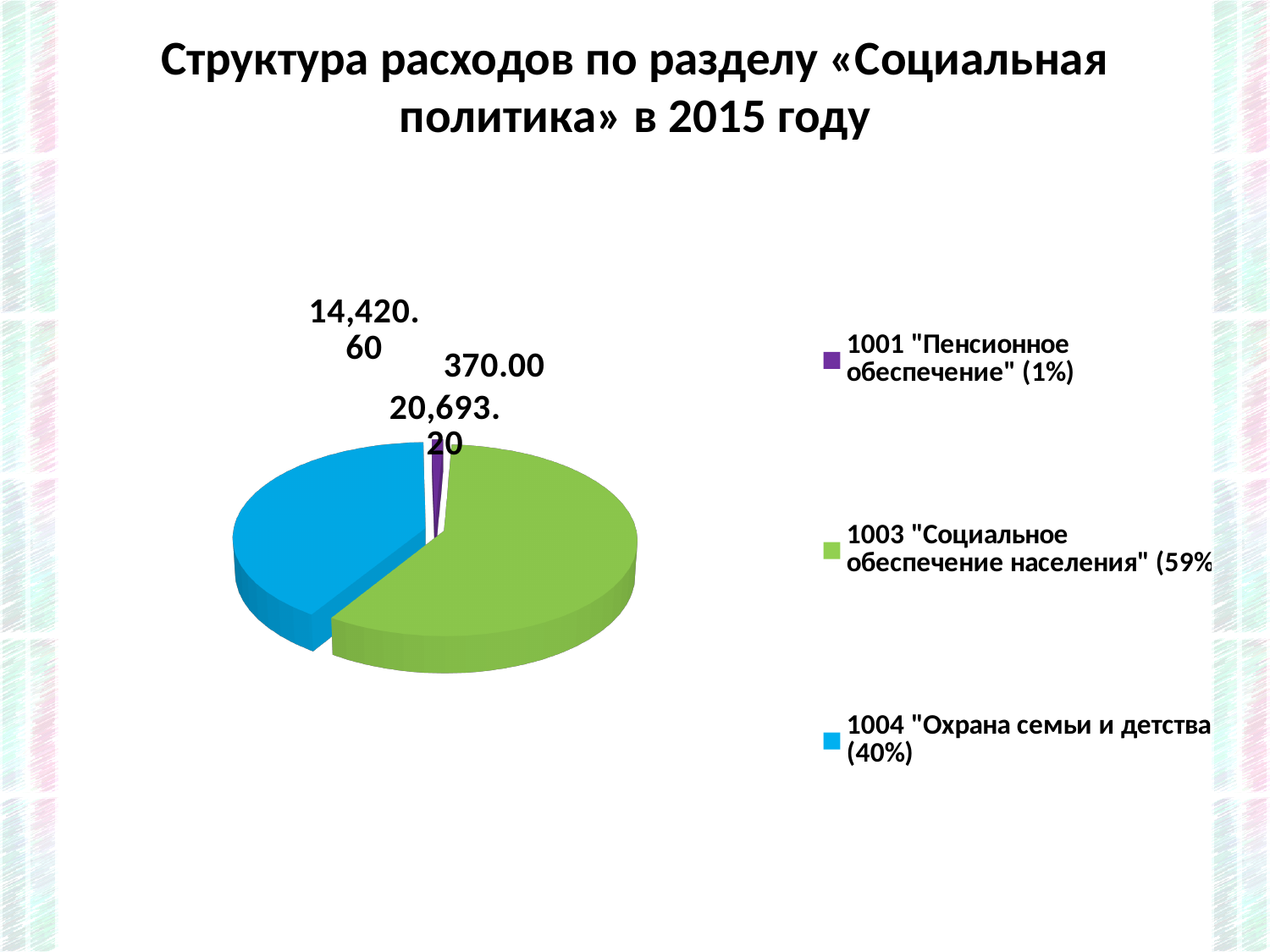
How many slices does the pie chart have? 3 What share of the pie does 1003 "Социальное обеспечение населения" represent? 59% How many entries does the legend list? 3 Which is larger: the value for 1003 "Социальное обеспечение населения" or for 1004 "Охрана семьи и детства"? 1003 "Социальное обеспечение населения" What is the difference between the values for 1003 "Социальное обеспечение населения" and 1004 "Охрана семьи и детства"? 6,272.60 What is the value for 1001 "Пенсионное обеспечение"? 370.00 What share of the pie does 1004 "Охрана семьи и детства" represent? 40% What kind of chart is shown on the slide? pie chart Which category has the smallest share of the pie? 1001 "Пенсионное обеспечение" Which category has the largest share of the pie? 1003 "Социальное обеспечение населения" What is the value for 1004 "Охрана семьи и детства"? 14,420.60 What is the value for 1003 "Социальное обеспечение населения"? 20,693.20